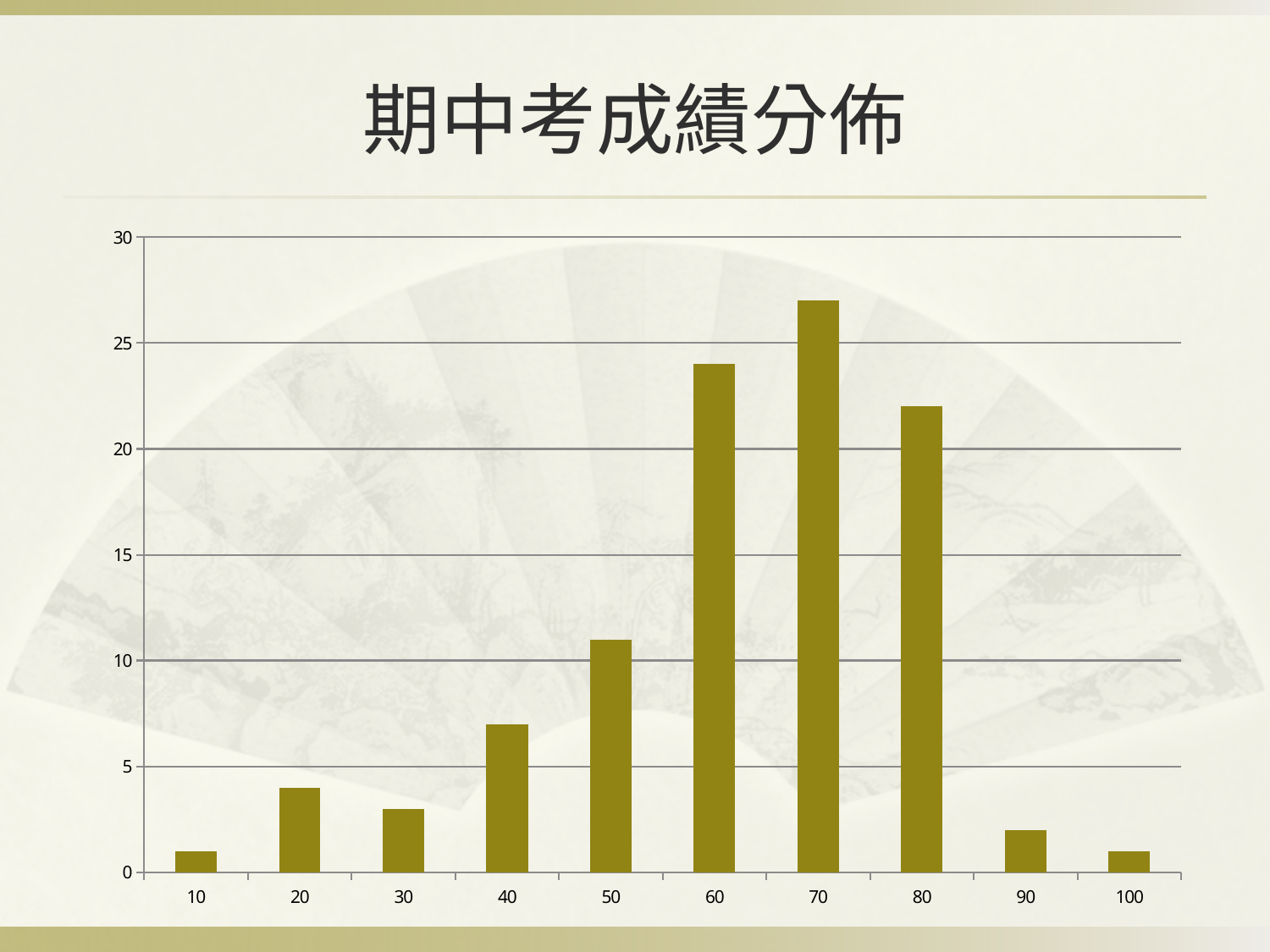
How many categories are shown on the x axis? 10 What is the title of the chart? 期中考成績分佈 Which has the larger value, 70 or 60? 70 Is the value for 80 greater or less than 20? greater Is the value for 30 greater or less than 5? less Which category has the highest bar? 70 What kind of chart is shown on the slide? bar chart Is the value for 50 greater or less than 10? greater Which has the larger value, 50 or 40? 50